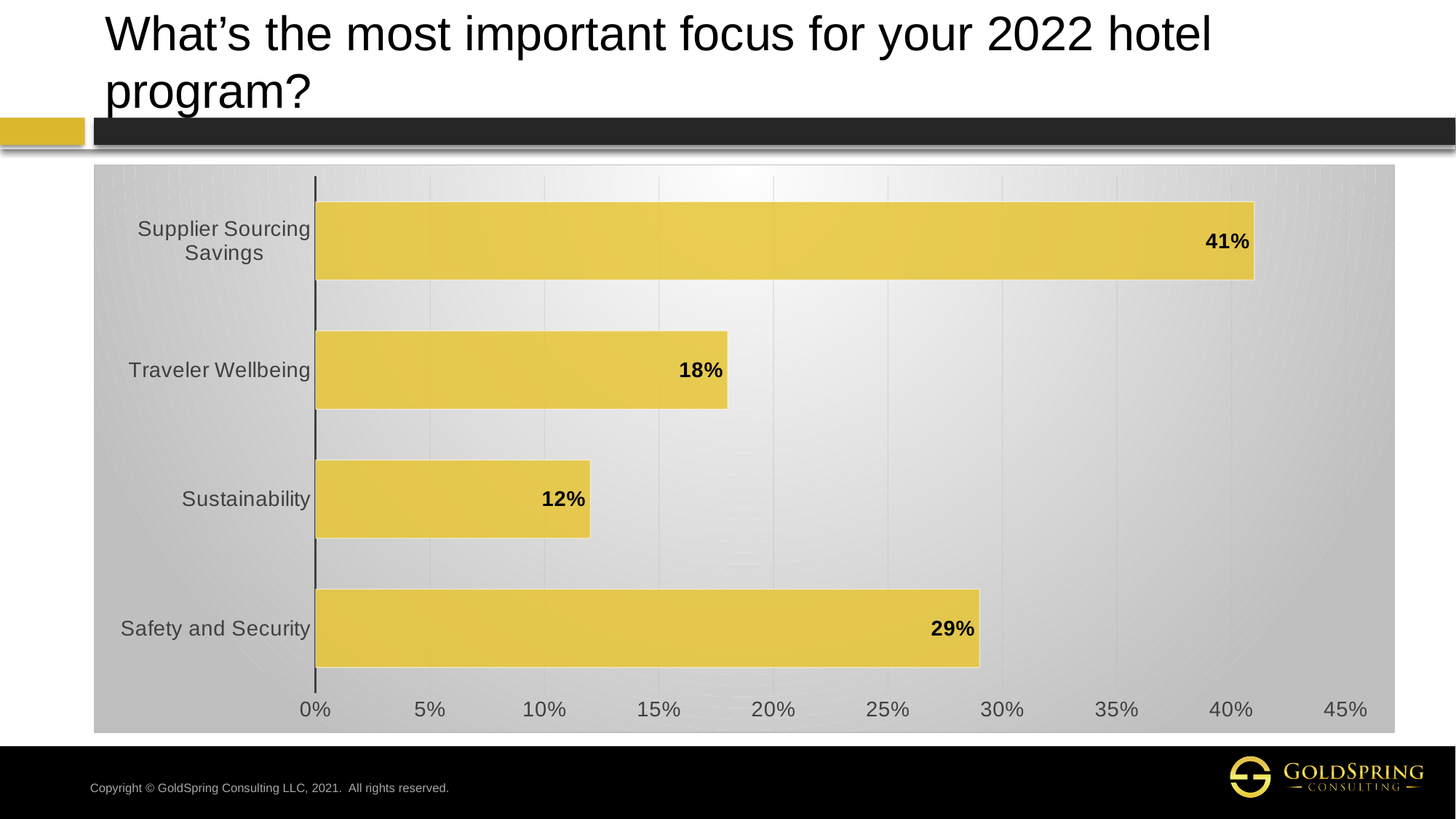
What is the difference in percentage points between Supplier Sourcing Savings and Safety and Security? 12% What percentage of respondents chose Supplier Sourcing Savings as the most important focus? 41% What is the value shown for Traveler Wellbeing? 18% How many focus areas are shown in the chart? 4 What kind of chart is shown on the slide? Bar chart Which focus area has the highest percentage? Supplier Sourcing Savings What is the highest value shown on the horizontal axis? 45% Which focus area has the lowest percentage? Sustainability Which is larger, the value for Traveler Wellbeing or the value for Safety and Security? Safety and Security What is the value shown for Sustainability? 12% Is the value for Safety and Security greater or less than 25%? greater What is the value shown for Safety and Security? 29%